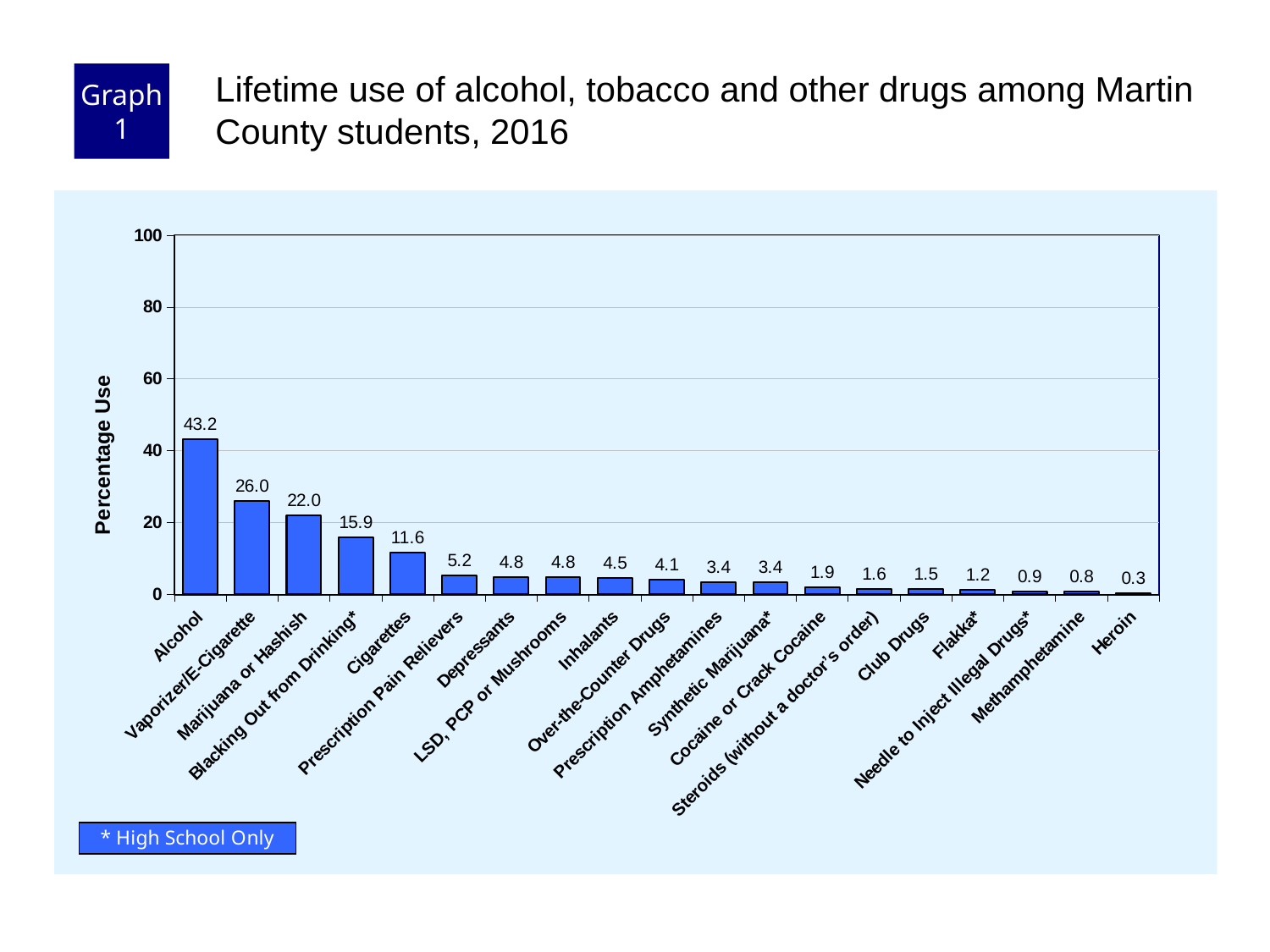
What kind of chart is shown on the slide? Bar chart What is the value shown for Cigarettes? 11.6 What is the value shown for Synthetic Marijuana*? 3.4 Which category has the lowest value? Heroin How many categories are shown on the x axis? 19 What is the lifetime use percentage for Alcohol? 43.2 Which category has the highest value? Alcohol What is the difference between the values for Alcohol and Vaporizer/E-Cigarette? 17.2 What is the difference between the values for Marijuana or Hashish and Blacking Out from Drinking*? 6.1 What is the label of the y axis? Percentage Use Which is larger, the value for Inhalants or the value for Over-the-Counter Drugs? Inhalants Is the value for Vaporizer/E-Cigarette greater or less than 20? greater